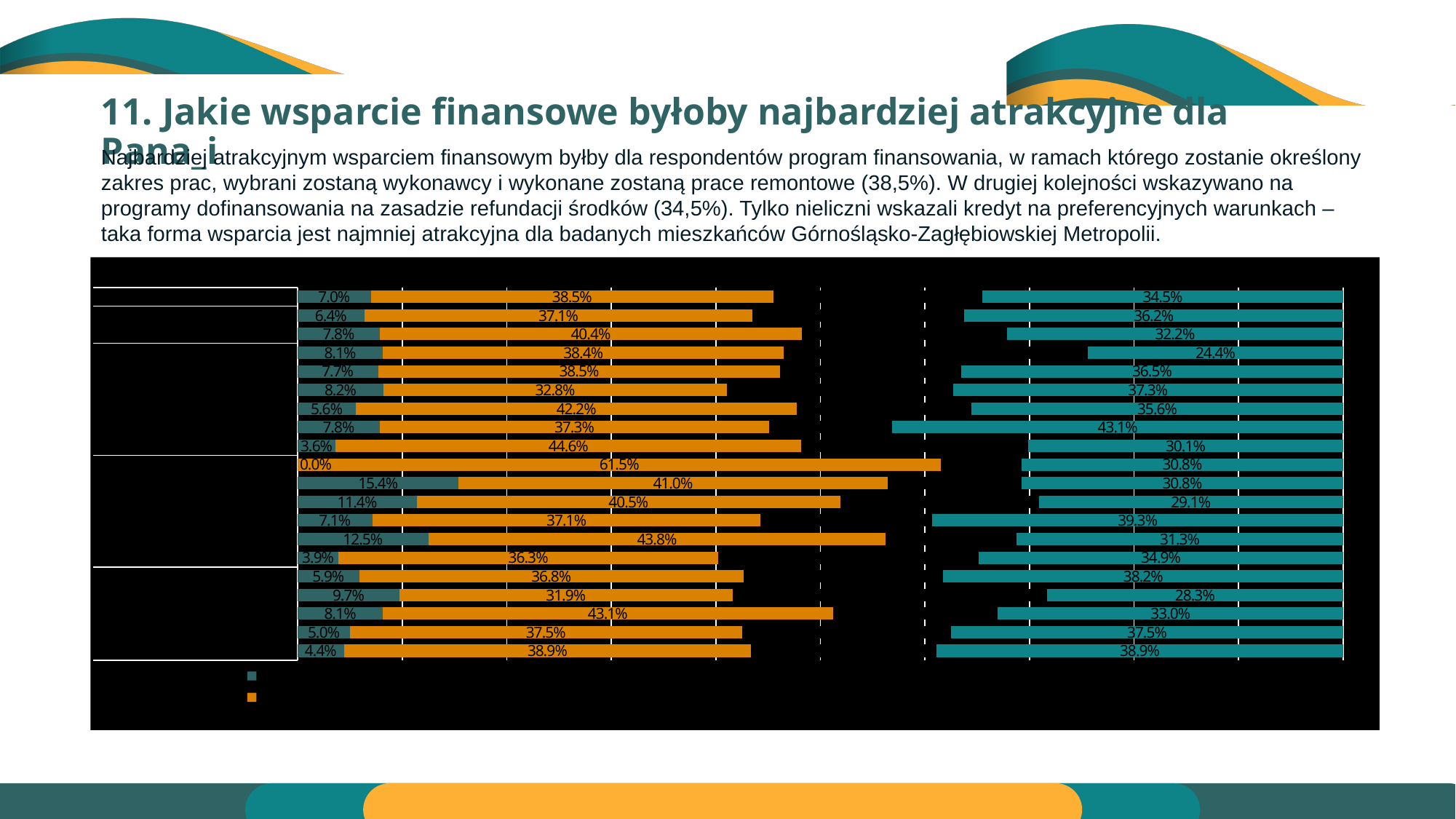
In the bottom row of the chart, what value is printed on the small dark bar at the far left? 4.4% How many rows of bars does the chart contain? 20 What is the lowest value printed on any of the teal bars on the right side of the chart? 24.4% In the top row of the chart, what value is printed on the teal bar on the right side? 34.5% What is the highest value printed on any of the teal bars on the right side of the chart? 43.1% What kind of chart is shown on the slide? bar chart In the top row of the chart, what is the difference between the orange bar value and the right-hand teal bar value? 4.0 percentage points In the top row of the chart, what value is printed on the orange bar? 38.5% In the bottom row of the chart, what value is printed on the orange bar? 38.9% What is the highest value printed on any orange bar in the chart? 61.5% What is the lowest value printed on any orange bar in the chart? 31.9% In the top row of the chart, which is larger: the orange bar value or the right-hand teal bar value? the orange bar value